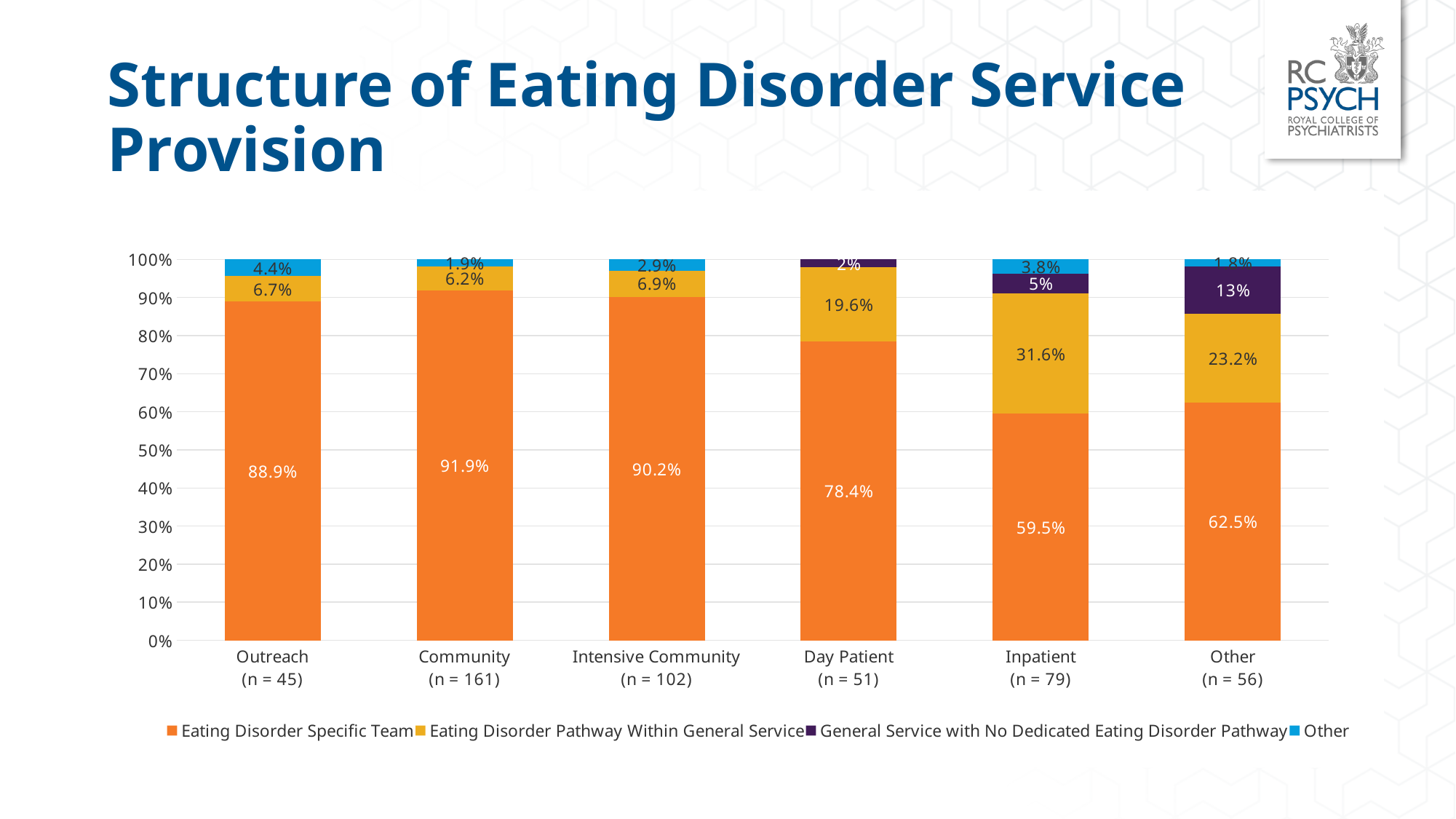
What is the sample size (n) shown for Community? 161 What kind of chart is shown on the slide? Stacked bar chart Which category has the highest Eating Disorder Specific Team percentage? Community What is the General Service with No Dedicated Eating Disorder Pathway percentage for Other? 13% How many service types (categories) are shown on the x axis? 6 What is the Other (series) percentage for Outreach? 4.4% What is the Eating Disorder Pathway Within General Service percentage for Day Patient? 19.6% Which category has the lowest Eating Disorder Specific Team percentage? Inpatient What is the difference between the Eating Disorder Pathway Within General Service percentages for Inpatient and Other? 8.4% What is the Eating Disorder Specific Team percentage for Inpatient? 59.5% Which has a larger Eating Disorder Specific Team percentage, Outreach or Intensive Community? Intensive Community How many series does the legend list? 4